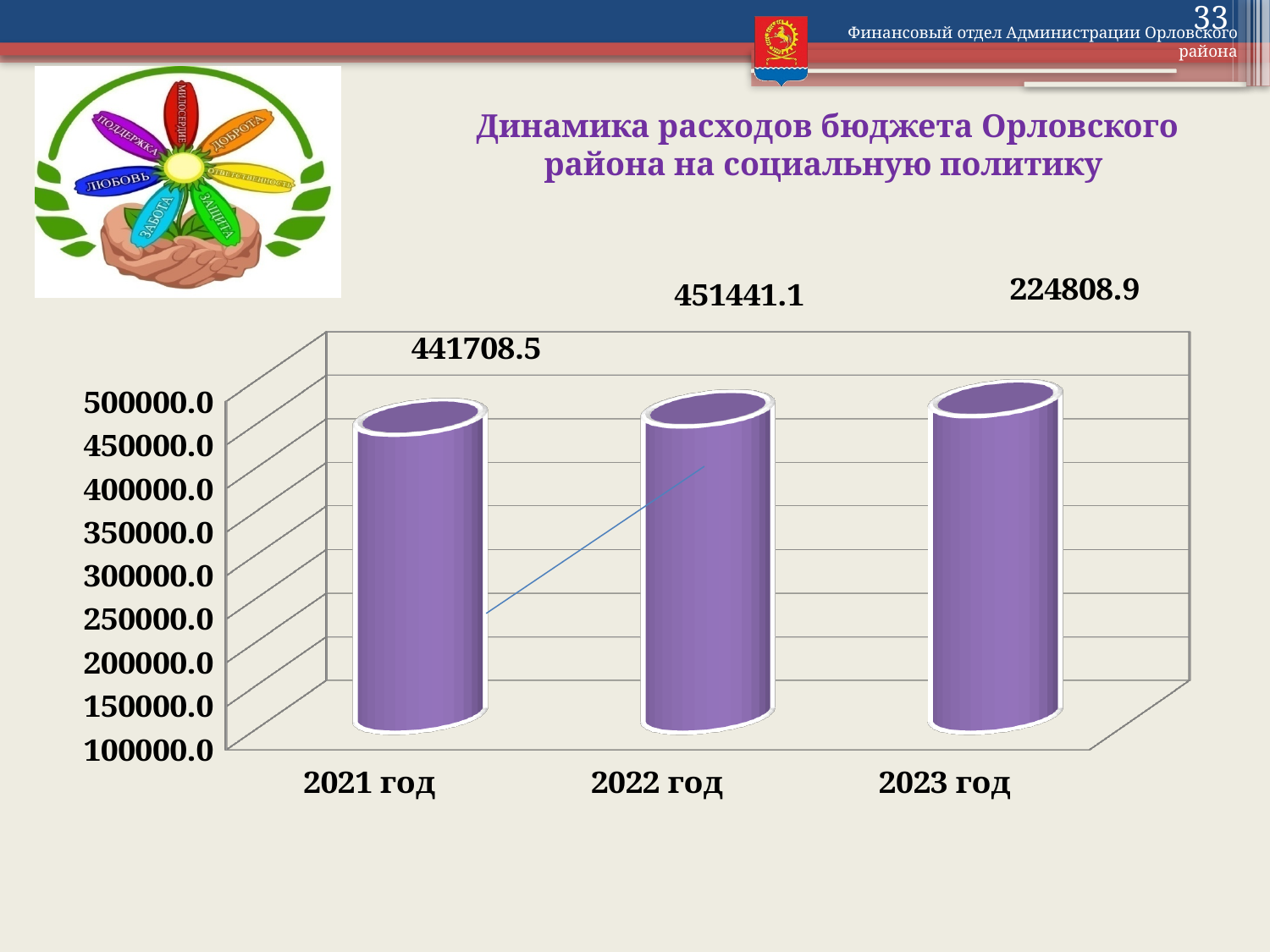
What is the difference between the values for 2021 год and 2023 год? 216899.6 What is the value for 2022 год? 451441.1 Which year has the highest value according to the data labels? 2022 год Which is larger, the value for 2021 год or the value for 2022 год? 2022 год Which year has the lowest value according to the data labels? 2023 год What is the title of the chart? Динамика расходов бюджета Орловского района на социальную политику According to the data labels, do the values rise or fall from 2022 год to 2023 год? Fall What is the difference between the values for 2022 год and 2021 год? 9732.6 What is the value for 2021 год? 441708.5 What kind of chart is shown on the slide? Bar chart How many years are shown on the chart? 3 What is the value for 2023 год? 224808.9